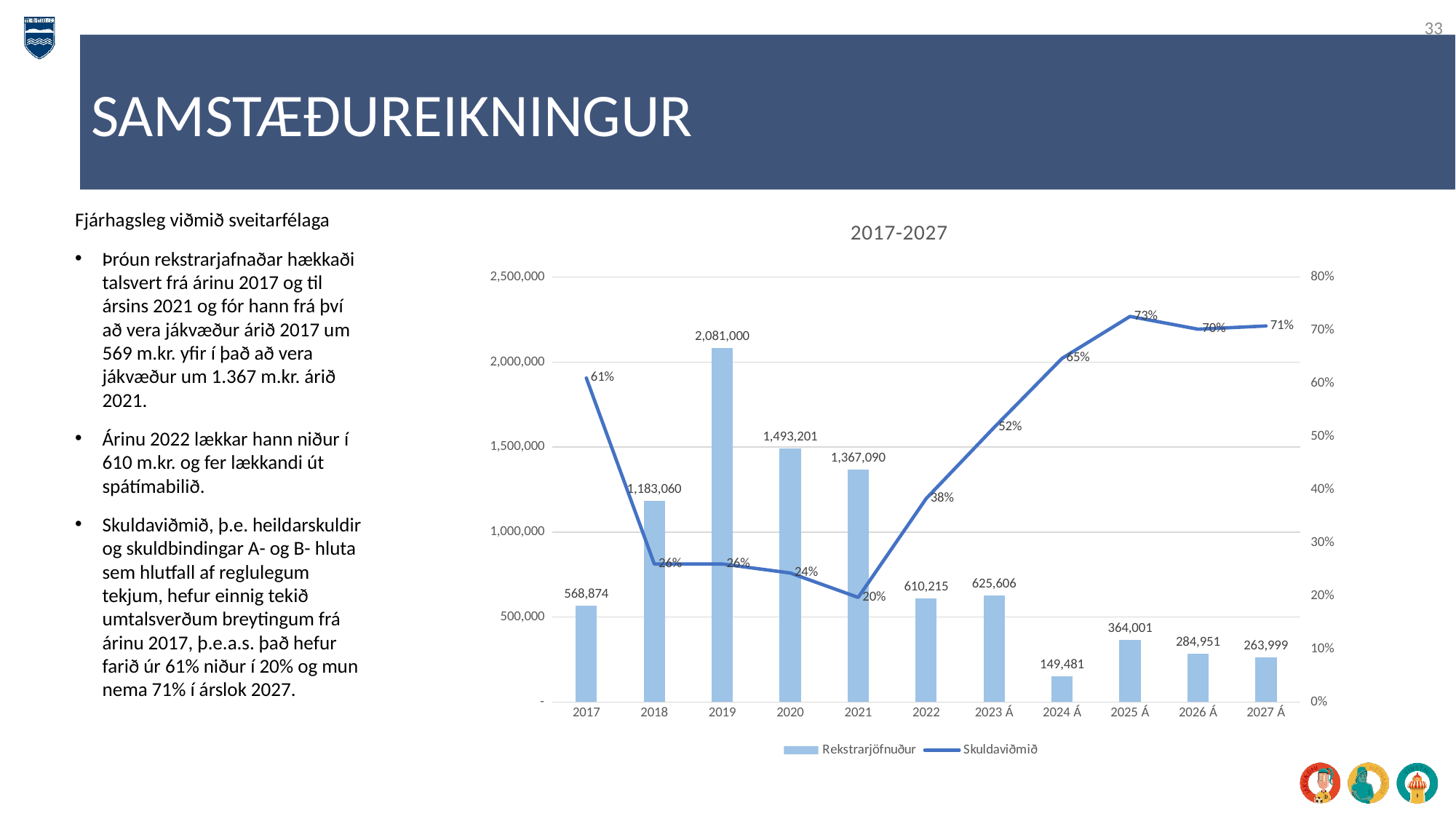
How many years are shown on the x axis? 11 What is the Rekstrarjöfnuður value for 2024 Á? 149,481 What is the Skuldaviðmið value for 2021? 20% Which is larger, the Rekstrarjöfnuður value for 2022 or for 2023 Á? 2023 Á Is the Rekstrarjöfnuður value for 2018 greater or less than 1,000,000? greater What is the title of the chart? 2017-2027 What is the difference between the Rekstrarjöfnuður values for 2020 and 2021? 126,111 Which year has the highest Skuldaviðmið value? 2025 Á Which year has the highest Rekstrarjöfnuður bar? 2019 Which year has the lowest Rekstrarjöfnuður bar? 2024 Á How many series does the legend list? 2 What is the Rekstrarjöfnuður value for 2019? 2,081,000